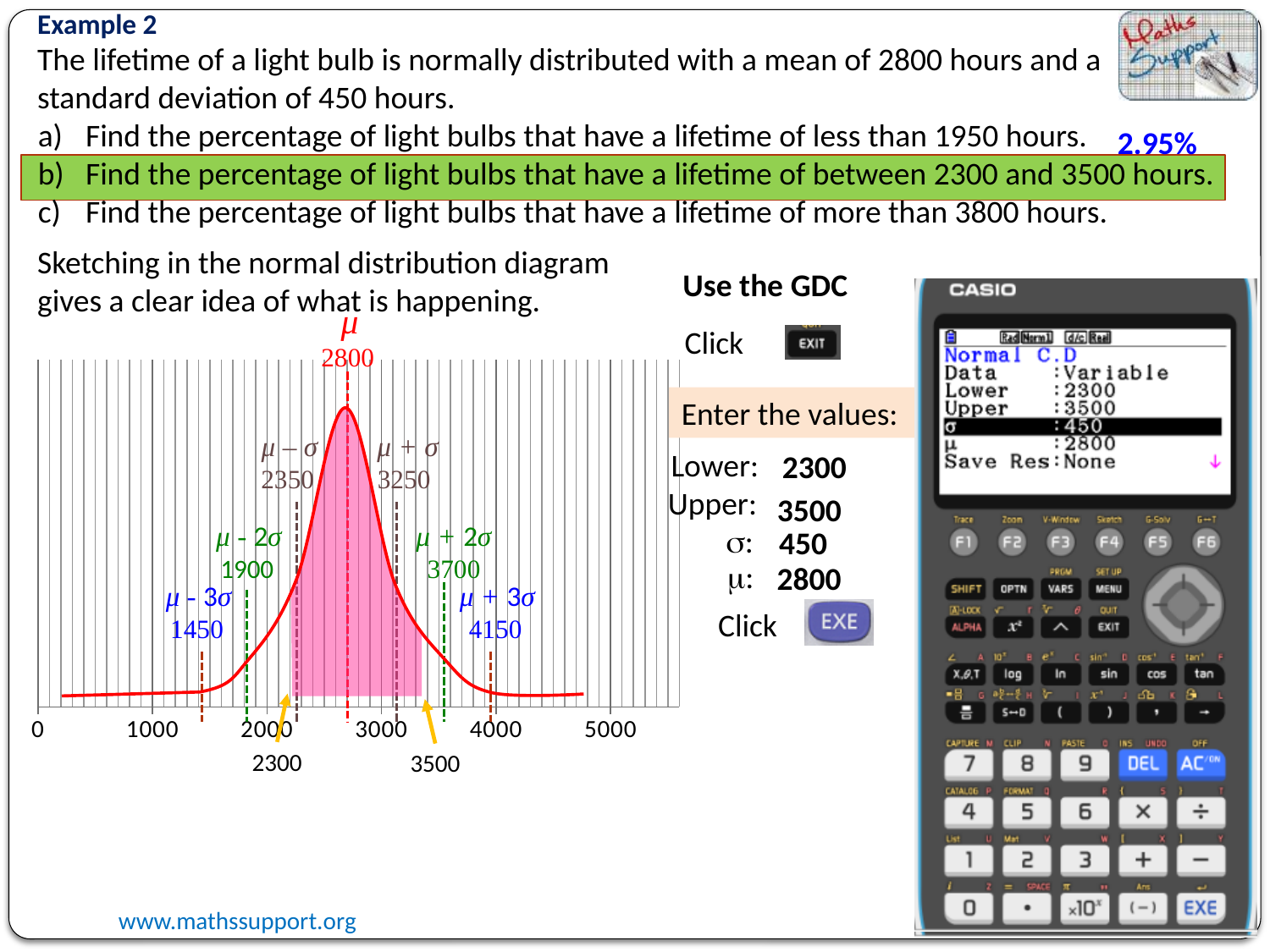
What colour is the shaded region under the curve on the normal distribution diagram? pink How many numbered tick labels are shown on the x axis of the normal distribution diagram? 6 On the normal distribution diagram, what value is labelled at the peak of the curve (μ)? 2800 On the normal distribution diagram, is the value labelled μ − 3σ greater or less than 2000? less On the normal distribution diagram, what is the difference between the values labelled μ + σ and μ − σ? 900 On the normal distribution diagram, what value is labelled μ + 3σ? 4150 What kind of chart is the normal distribution diagram? line chart On the normal distribution diagram, what value is labelled μ + σ? 3250 On the normal distribution diagram, what value is labelled μ − 3σ? 1450 On the normal distribution diagram, what value is labelled μ − 2σ? 1900 On the normal distribution diagram, what is the difference between the values labelled μ + 3σ and μ − 3σ? 2700 On the normal distribution diagram, what are the lower and upper bounds of the shaded region marked by the arrows? 2300 and 3500